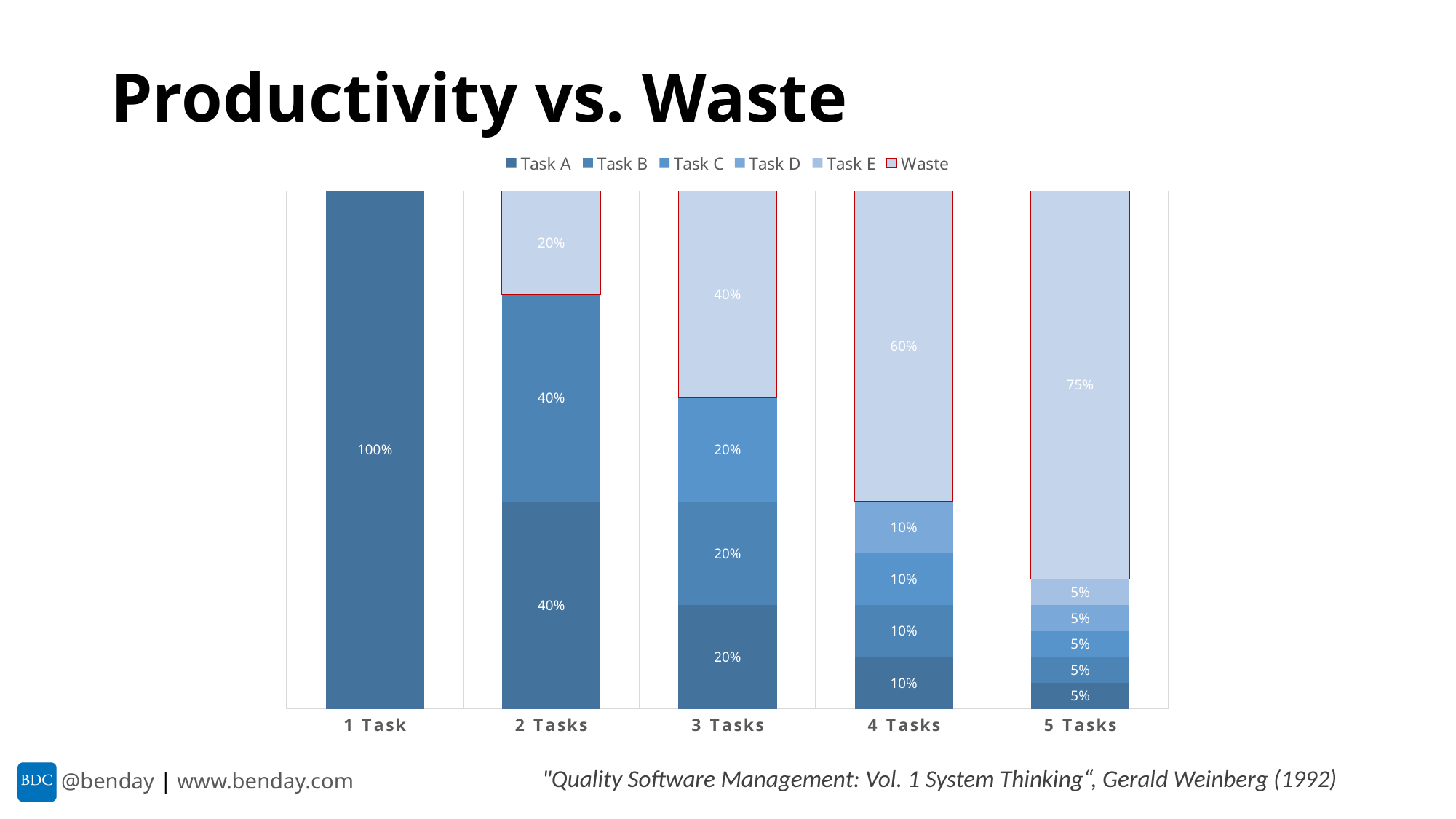
How many categories are shown on the x axis? 5 What is the Waste value for 5 Tasks? 75% What is the Task D value for 4 Tasks? 10% What is the difference between the Waste value for 4 Tasks and the Waste value for 2 Tasks? 40% What kind of chart is shown on the slide? Stacked bar chart Which category has the largest Waste segment? 5 Tasks Which is larger: the Task A value for 3 Tasks or the Task A value for 4 Tasks? 3 Tasks What is the Waste value for 3 Tasks? 40% Which category has the smallest Task A segment? 5 Tasks Does the Waste value rise or fall as the number of tasks increases from 2 Tasks to 5 Tasks? Rise What is the Task A value for 2 Tasks? 40% How many series does the legend list? 6